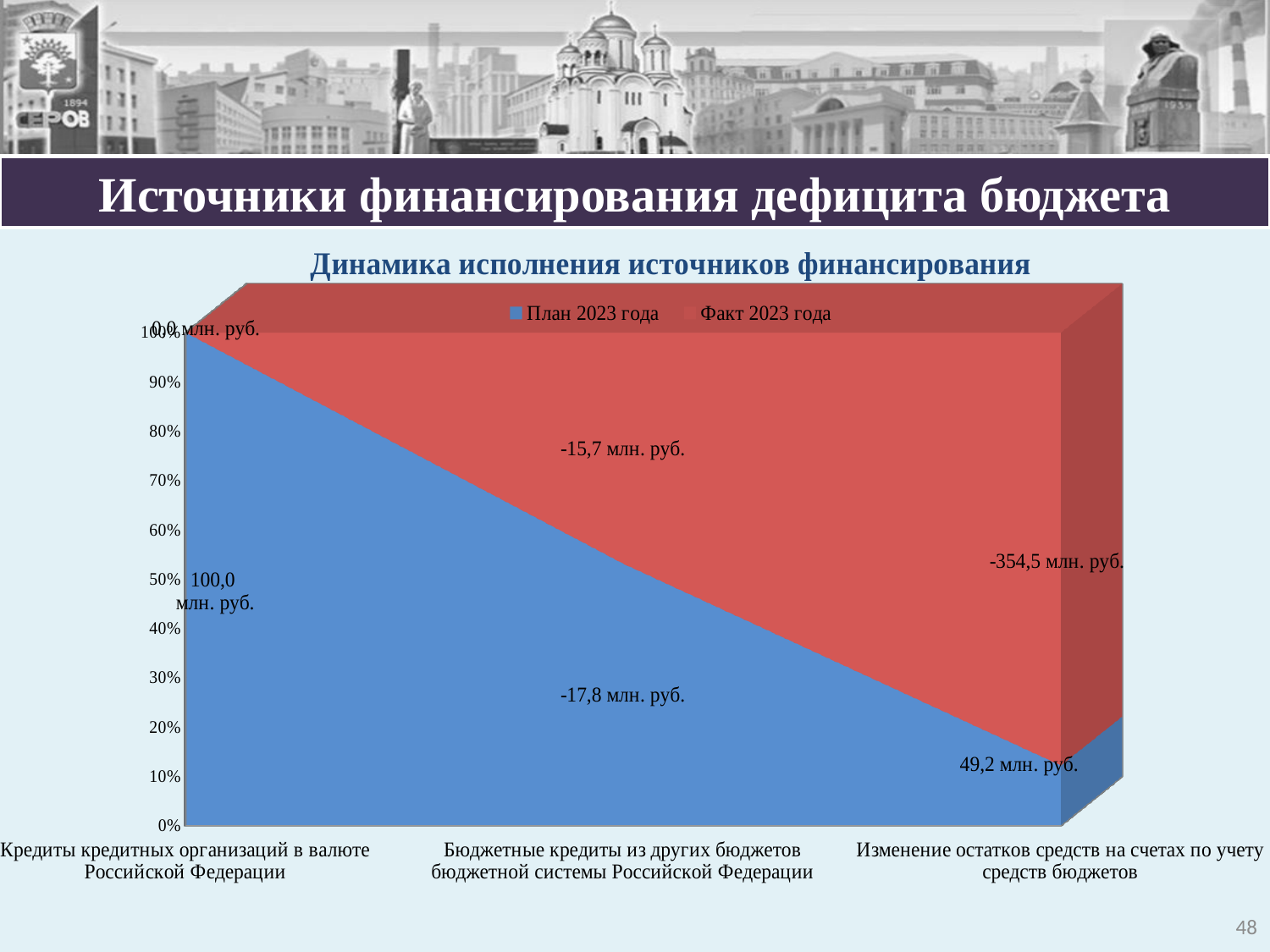
What is the title of the chart? Динамика исполнения источников финансирования What is the value of План 2023 года for Бюджетные кредиты из других бюджетов бюджетной системы Российской Федерации? -17,8 млн. руб. How many series does the chart legend list? 2 What is the value of План 2023 года for Изменение остатков средств на счетах по учету средств бюджетов? 49,2 млн. руб. How many categories are shown on the x axis of the chart? 3 What is the value of План 2023 года for Кредиты кредитных организаций в валюте Российской Федерации? 100,0 млн. руб. What is the value of Факт 2023 года for Изменение остатков средств на счетах по учету средств бюджетов? -354,5 млн. руб. What is the value of Факт 2023 года for Кредиты кредитных организаций в валюте Российской Федерации? 0,0 млн. руб. Which category has the highest План 2023 года value? Кредиты кредитных организаций в валюте Российской Федерации Which category has the lowest Факт 2023 года value? Изменение остатков средств на счетах по учету средств бюджетов For Изменение остатков средств на счетах по учету средств бюджетов, which is larger: План 2023 года or Факт 2023 года? План 2023 года What is the value of Факт 2023 года for Бюджетные кредиты из других бюджетов бюджетной системы Российской Федерации? -15,7 млн. руб.